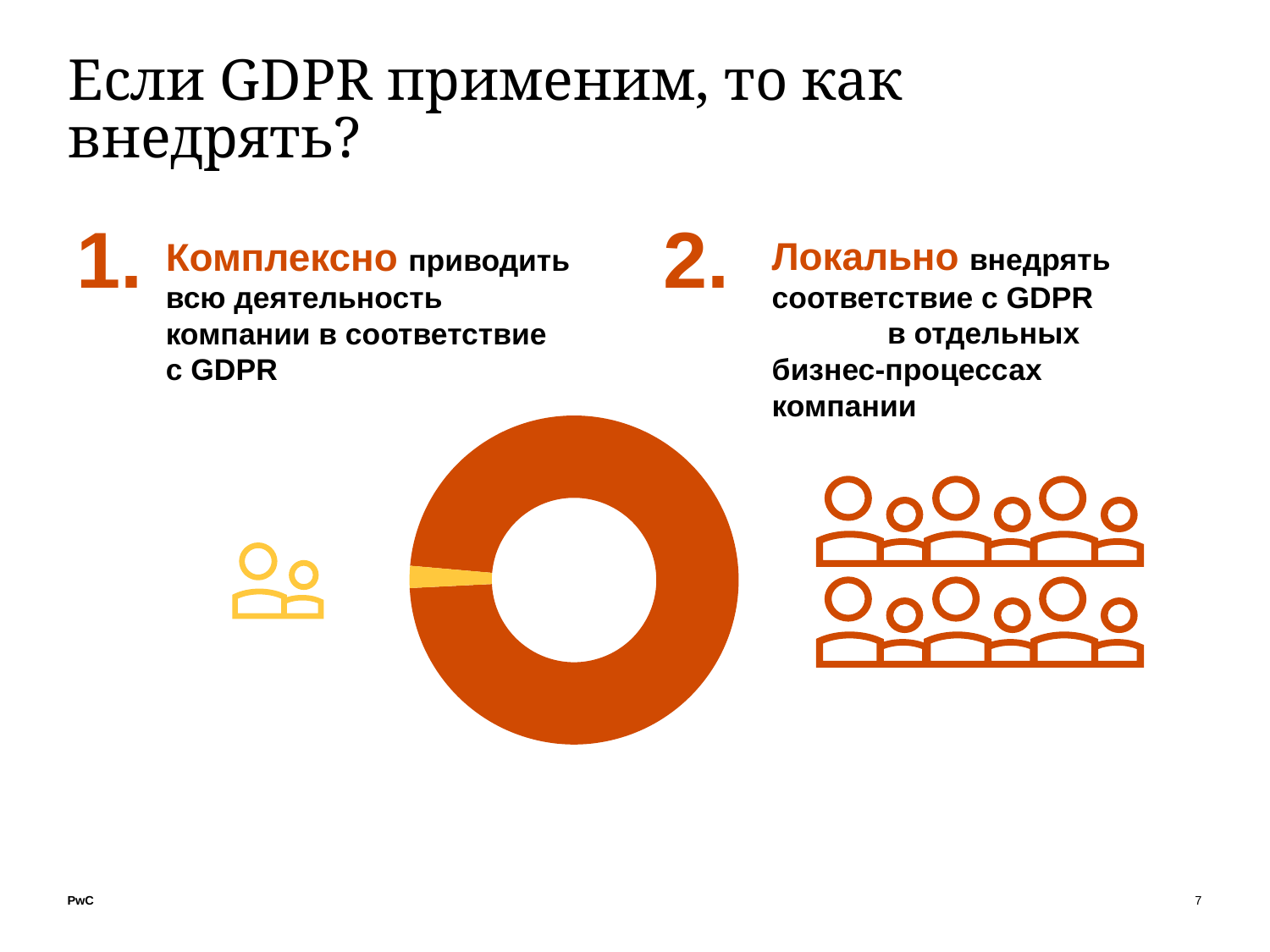
Which slice of the doughnut chart is larger, the orange one or the yellow one? The orange one Which slice of the doughnut chart is the smallest? The yellow slice How many slices does the doughnut chart have? 2 What kind of chart is shown in the centre of the slide? Doughnut (pie) chart Does the doughnut chart display any data labels or a legend? No What colour is the largest slice of the doughnut chart? Orange Is the yellow slice of the doughnut chart greater or less than half of the chart? less